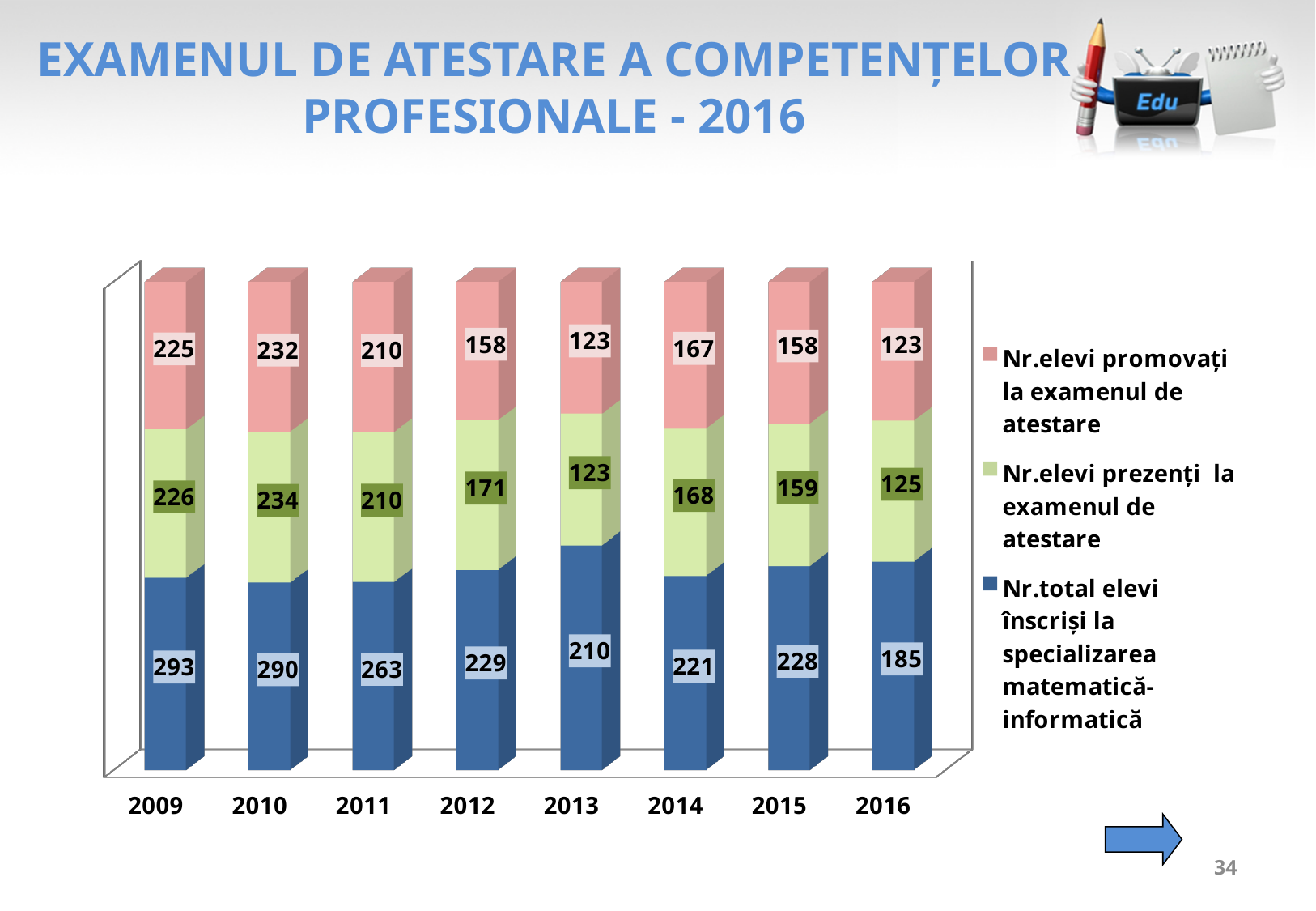
In which year is Nr.total elevi înscriși la specializarea matematică-informatică highest? 2009 How many series does the legend list? 3 What is the difference between Nr.elevi prezenți la examenul de atestare and Nr.elevi promovați la examenul de atestare in 2012? 13 What is the value for Nr.elevi prezenți la examenul de atestare in 2012? 171 Which is larger: Nr.elevi promovați la examenul de atestare in 2011 or in 2015? 2011 What is the value for Nr.elevi promovați la examenul de atestare in 2014? 167 How many years are shown on the x axis? 8 What is the difference between Nr.total elevi înscriși in 2009 and in 2016? 108 What kind of chart is shown on the slide? Stacked bar chart In which year is Nr.elevi promovați la examenul de atestare highest? 2010 What is the value for Nr.total elevi înscriși la specializarea matematică-informatică in 2009? 293 In which year is Nr.total elevi înscriși la specializarea matematică-informatică lowest? 2016